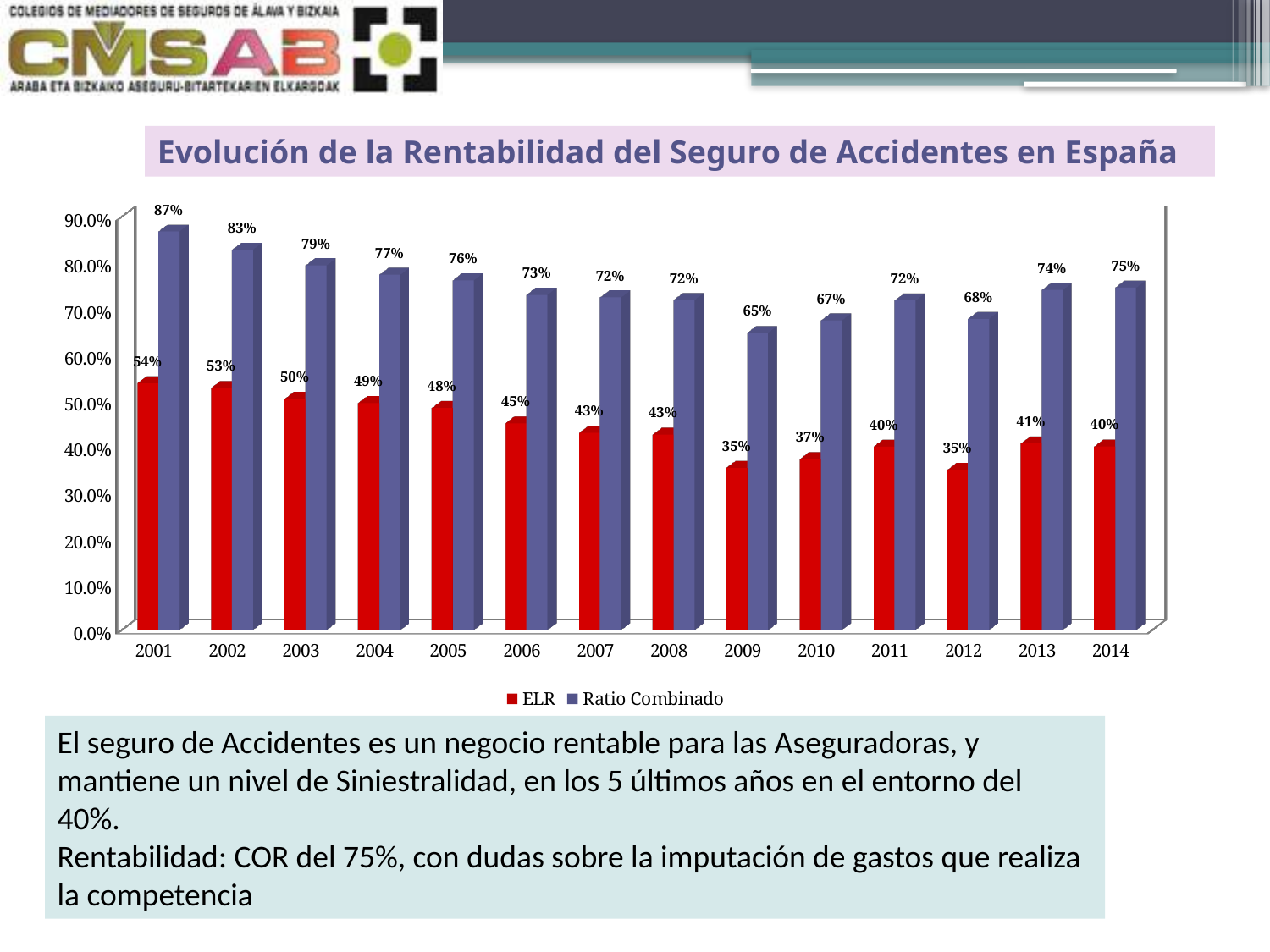
What kind of chart is shown on the slide? Bar chart Does the Ratio Combinado generally rise or fall from 2001 to 2009? Fall Which year has the lowest Ratio Combinado? 2009 How many years are shown on the x axis? 14 What is the ELR value for 2001? 54% How many series does the legend list? 2 What is the Ratio Combinado value for 2009? 65% What is the difference between the Ratio Combinado and the ELR in 2001? 33% Which year has the highest Ratio Combinado? 2001 What is the difference between the ELR in 2001 and the ELR in 2014? 14% Which is larger, the ELR in 2003 or the ELR in 2012? 2003 What is the Ratio Combinado value for 2014? 75%